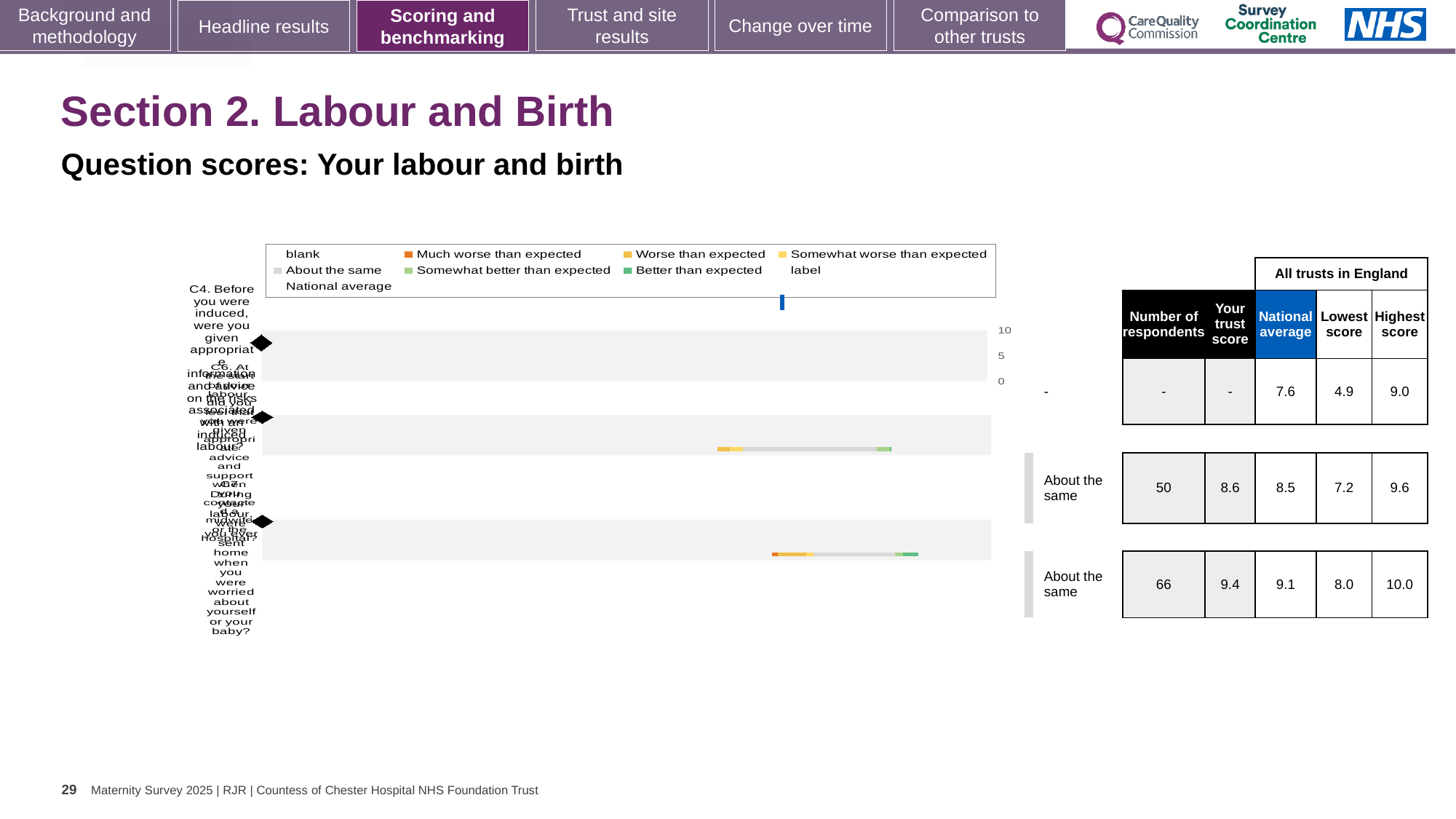
In the table beside the chart, is the trust score for the second row (8.6) larger or smaller than its national average (8.5)? larger Which colour does the legend use for 'Much worse than expected'? orange What kind of chart is shown on the slide? bar chart In the table beside the chart, what is the national average for the second question row? 8.5 In the table beside the chart, what is the highest score for the first question row? 9.0 What is the highest tick value shown on the chart's axis? 10 In the table beside the chart, how many respondents are listed for the third question row? 66 In the table beside the chart, what is the trust score for the third question row? 9.4 How many question rows (categories) does the chart display? 3 How many entries does the chart's legend list? 9 In the table beside the chart, what is the difference between the highest score (9.6) and lowest score (7.2) for the second question row? 2.4